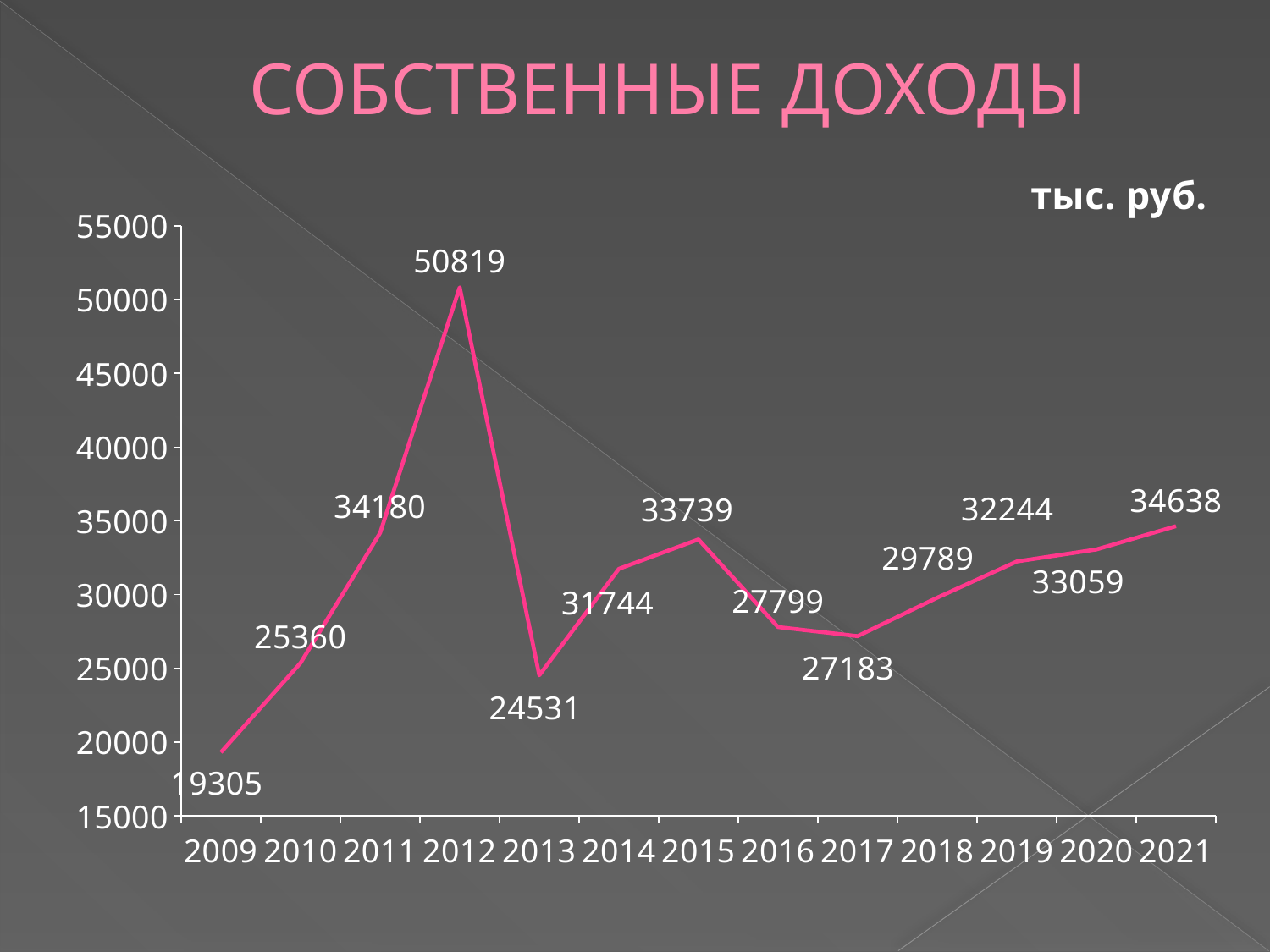
How many years are plotted on the chart? 13 What is the title of the chart? СОБСТВЕННЫЕ ДОХОДЫ What is the value for 2017? 27183 What type of chart is shown on the slide? line chart What is the value for 2012? 50819 What is the value for 2009? 19305 Does the value rise or fall from 2017 to 2021? rise What is the difference between the values for 2012 and 2013? 26288 Which is larger, the value for 2015 or the value for 2020? 2015 What is the value for 2021? 34638 Which year has the lowest value? 2009 Which year has the highest value? 2012